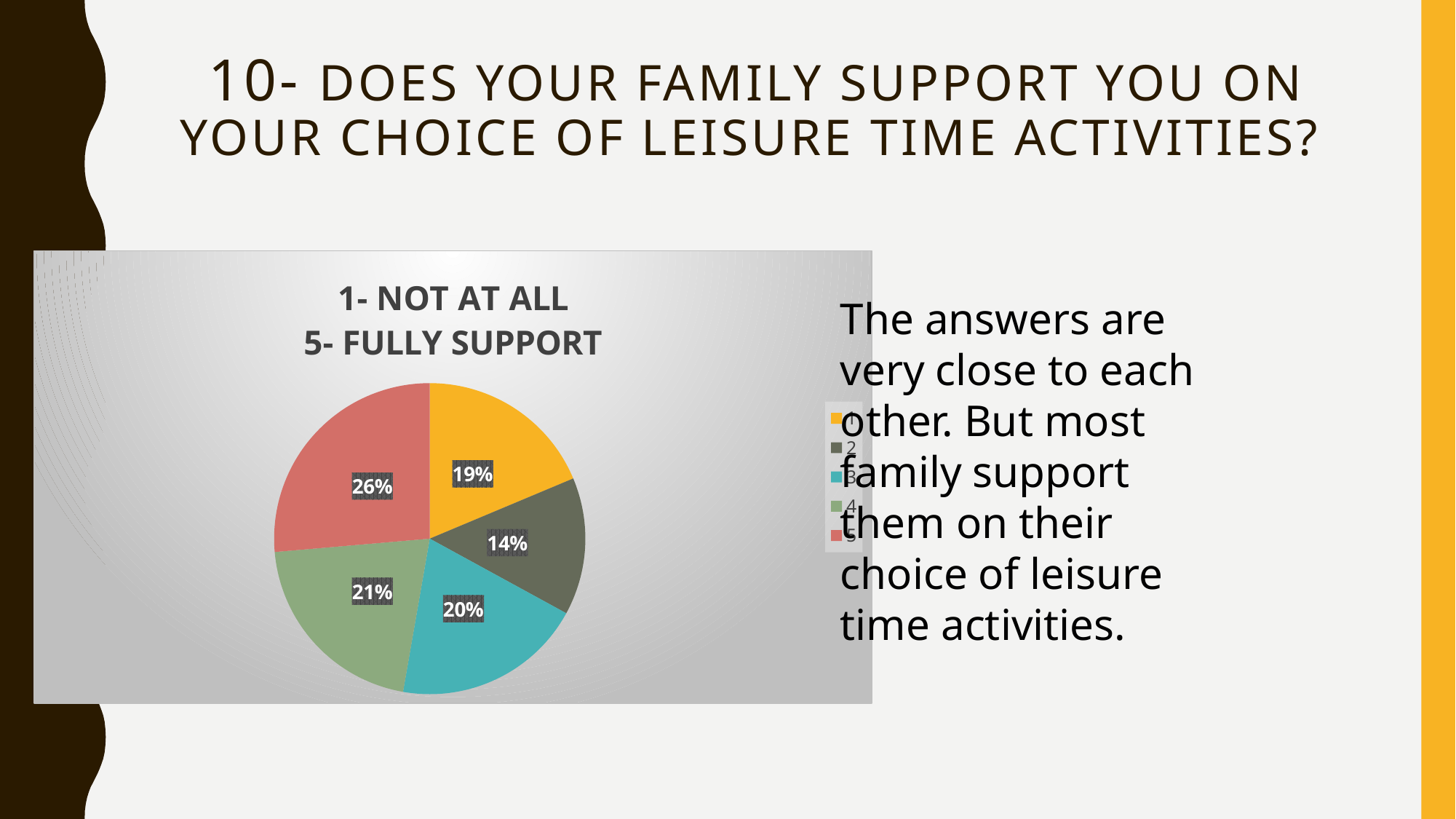
Which slice of the pie chart is the smallest? the dark olive slice (14%) Which slice is larger in the pie chart, the green slice or the teal slice? the green slice What percentage is shown on the green slice of the pie chart? 21% How many entries does the legend of the pie chart list? 5 How many slices does the pie chart have? 5 What is the title of the pie chart? 1- NOT AT ALL 5- FULLY SUPPORT What share of the pie does the red slice represent? 26% What percentage is shown on the teal slice of the pie chart? 20% What kind of chart is shown on the slide? pie chart What is the difference between the largest slice (26%) and the smallest slice (14%) of the pie chart? 12 percentage points What percentage is shown on the yellow slice of the pie chart? 19% Which slice of the pie chart is the largest? the red slice (26%)